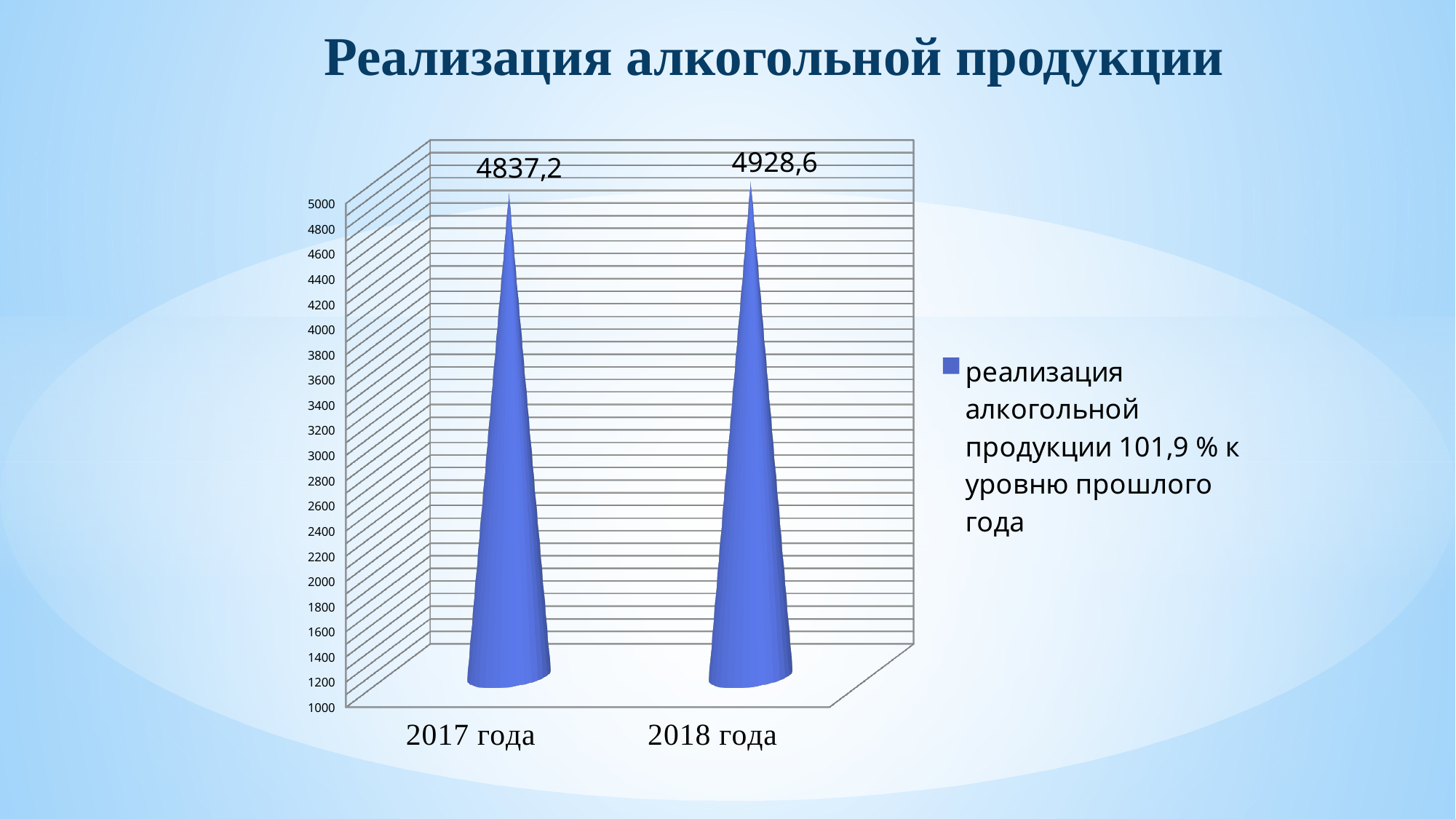
What kind of chart is shown on the slide? bar chart Which year has the higher value? 2018 года What is the value for 2018 года? 4928,6 What is the difference between the values for 2018 года and 2017 года? 91,4 Which year has the lower value? 2017 года How many categories are shown on the x axis? 2 How many series does the legend list? 1 Do the values rise or fall from 2017 года to 2018 года? rise Is the value for 2017 года larger or smaller than the value for 2018 года? smaller Is the value for 2017 года greater or less than 4000? greater What is the value for 2017 года? 4837,2 What is the title of the slide? Реализация алкогольной продукции